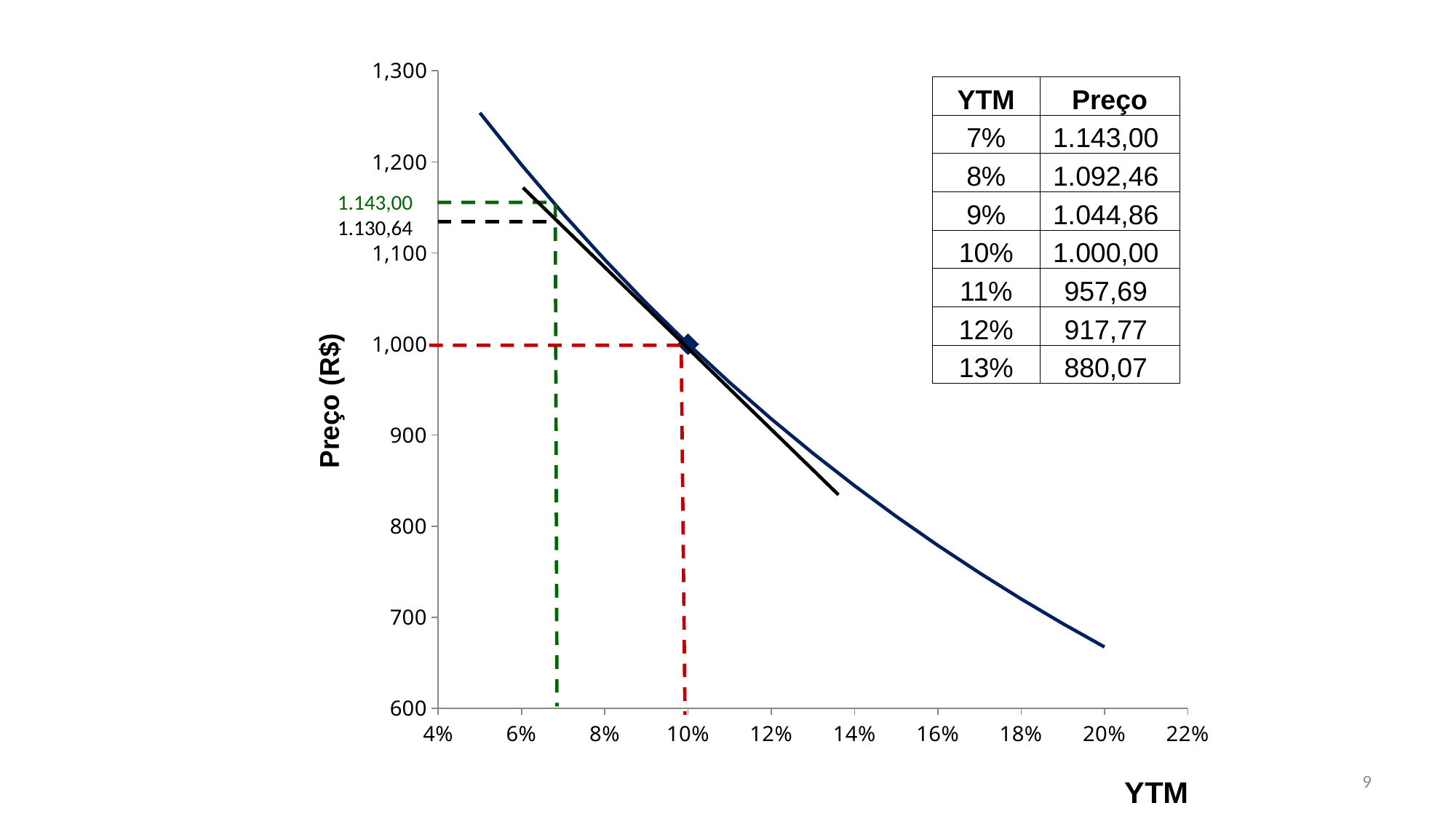
According to the table next to the chart, what is the Preço at a YTM of 13%? 880,07 Is the price on the curve at a YTM of 6% greater or less than 1,100? greater Is the price on the curve at a YTM of 14% greater or less than 900? less What price does the red dashed line mark on the y axis at a YTM of 10%? 1,000 According to the table next to the chart, what is the difference between the Preço at 7% and the Preço at 8%? 50,54 What is the label of the x axis of the chart? YTM What kind of chart is shown on the slide? line chart What price value is written in green next to the green dashed line on the chart? 1.143,00 As YTM increases along the x axis, does the price curve rise or fall? fall What price value is written in black next to the black dashed line on the chart? 1.130,64 Is the price on the curve at a YTM of 20% greater or less than 700? less What is the label of the y axis of the chart? Preço (R$)